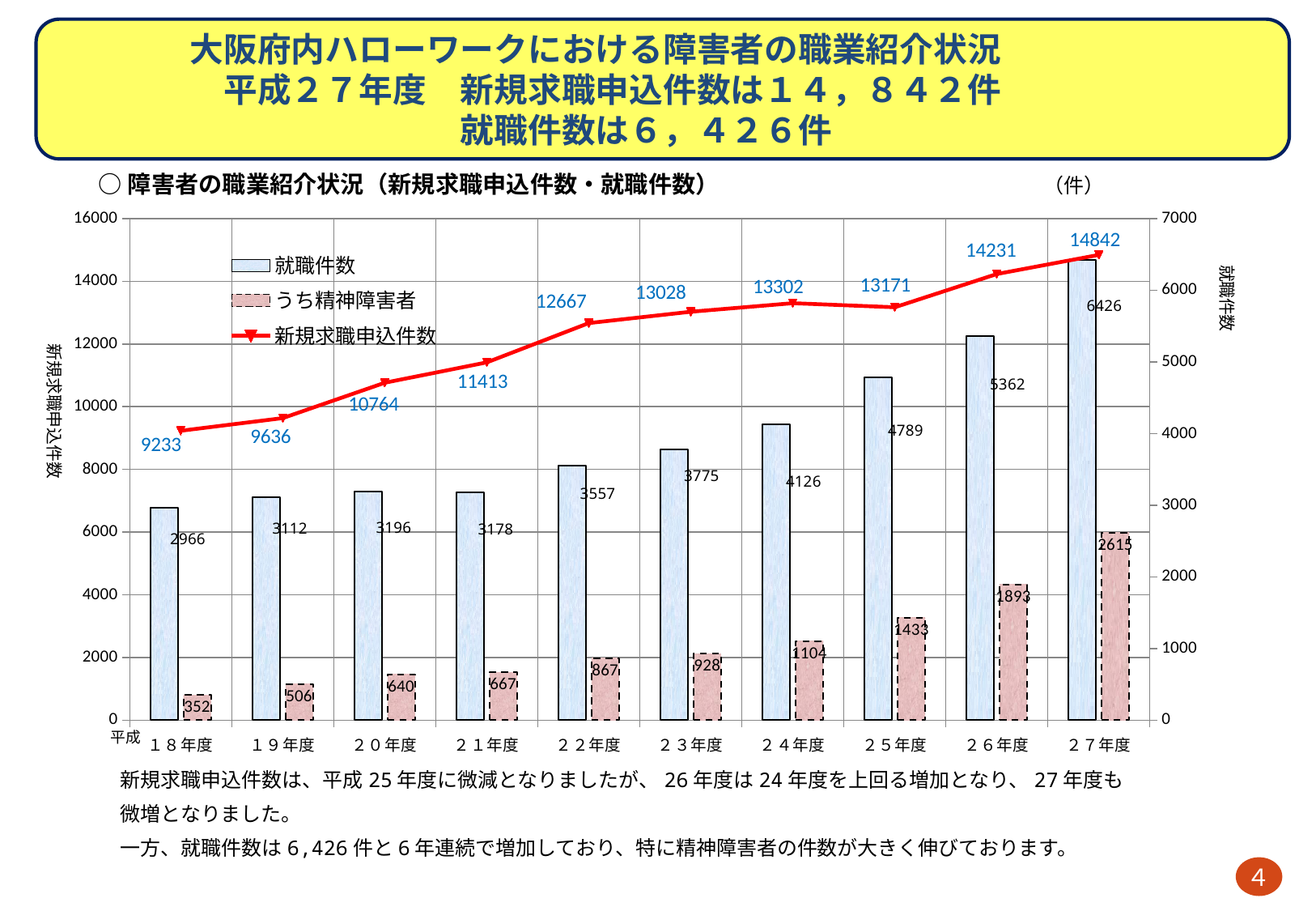
How many series does the legend list? 3 Which year has the highest 就職件数? ２７年度 What is the value of 就職件数 for 平成２４年度? 4126 What kind of chart is this? Combined bar and line chart How many fiscal years are shown on the x axis? 10 Which is larger, the 新規求職申込件数 for 平成２４年度 or for 平成２５年度? ２４年度 What is the difference between 就職件数 and うち精神障害者 for 平成２７年度? 3811 What is the value of うち精神障害者 for 平成２６年度? 1893 What is the difference in 新規求職申込件数 between 平成２７年度 and 平成２６年度? 611 What is the value of 新規求職申込件数 for 平成２７年度? 14842 Which year has the lowest 新規求職申込件数? １８年度 Does the 就職件数 series rise or fall from 平成２１年度 to 平成２７年度? Rise